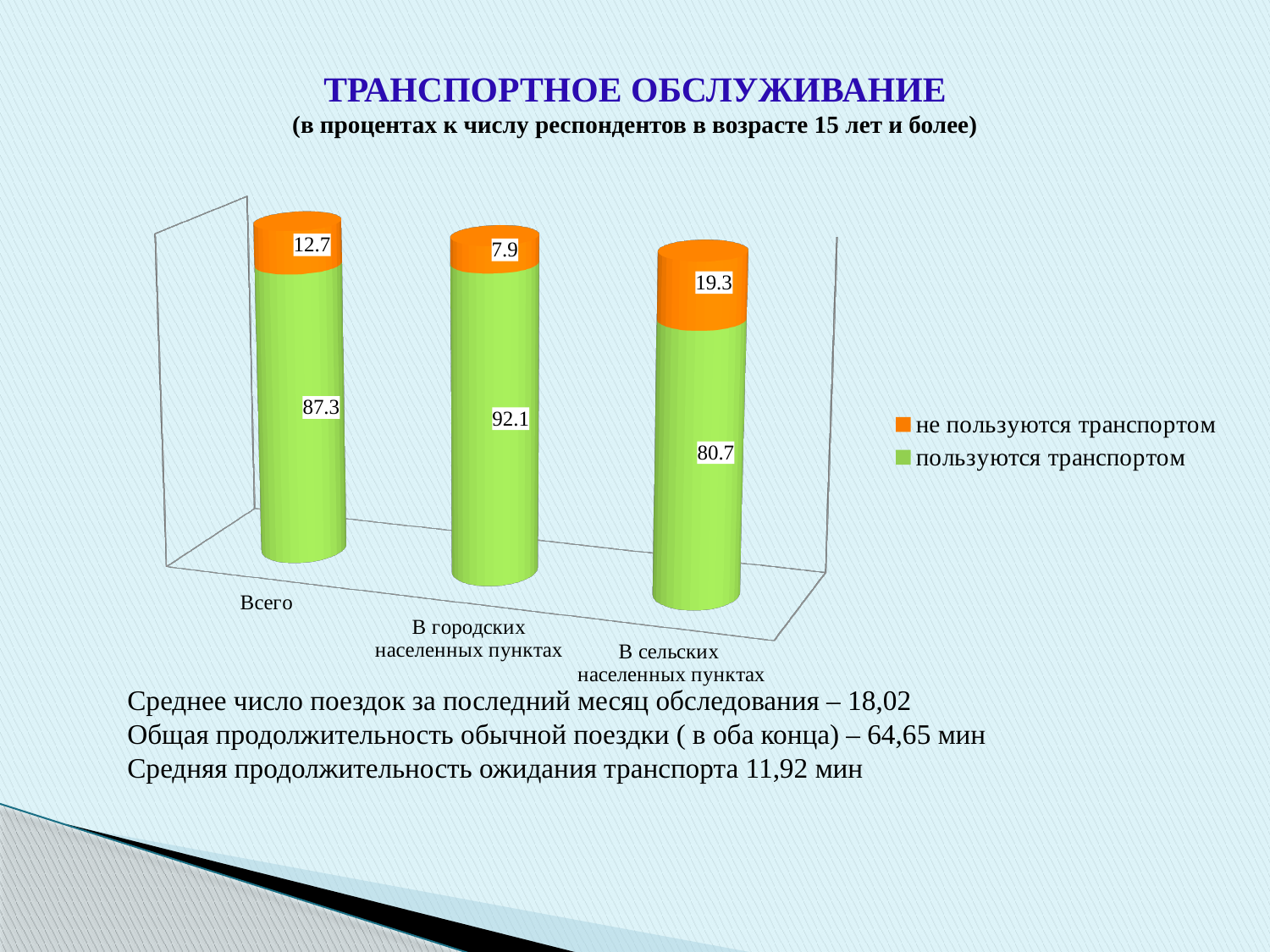
What is the value for "пользуются транспортом" in "В городских населенных пунктах"? 92.1 How many series does the legend list? 2 How many categories are shown on the x axis of the chart? 3 Which category has the highest value for "пользуются транспортом"? В городских населенных пунктах What is the value for "не пользуются транспортом" in "В сельских населенных пунктах"? 19.3 What is the value for "пользуются транспортом" in the "Всего" category? 87.3 What is the value for "не пользуются транспортом" in "В городских населенных пунктах"? 7.9 What is the difference between the "пользуются транспортом" values for "В городских населенных пунктах" and "В сельских населенных пунктах"? 11.4 Which category has the lowest value for "не пользуются транспортом"? В городских населенных пунктах What kind of chart is shown on the slide? Stacked bar chart Which is larger: the "не пользуются транспортом" value for "Всего" or for "В сельских населенных пунктах"? В сельских населенных пунктах What is the total of the stacked bar for "Всего"? 100